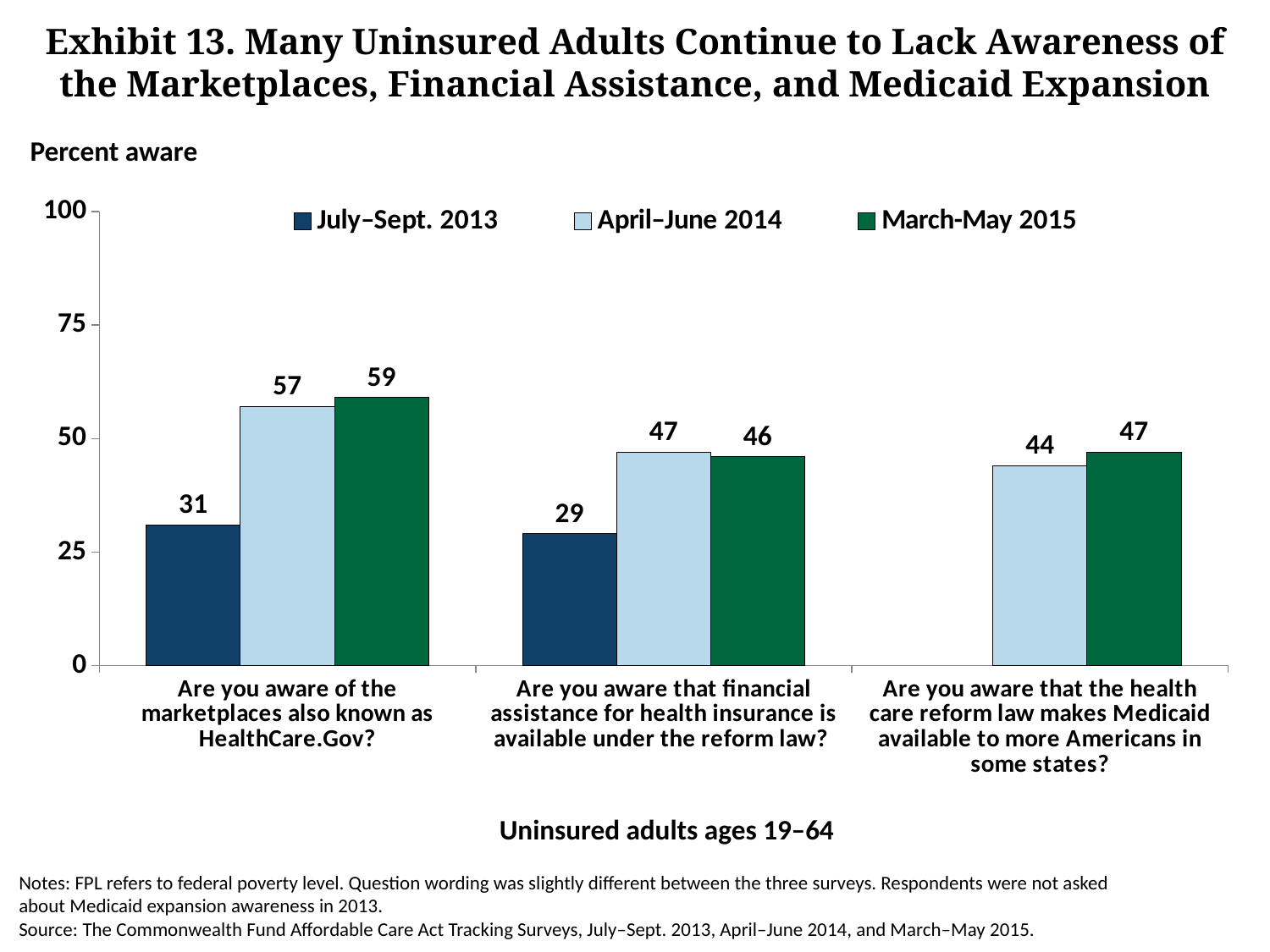
What percent of uninsured adults were aware that the reform law makes Medicaid available to more Americans in April–June 2014? 44 Which survey period has no bar for the Medicaid expansion awareness question? July–Sept. 2013 How many series does the legend list? 3 What percent of uninsured adults were aware of the marketplaces (HealthCare.Gov) in March-May 2015? 59 Which survey period had the highest awareness of the marketplaces also known as HealthCare.Gov? March-May 2015 By how many percentage points did awareness of the marketplaces increase from July–Sept. 2013 to April–June 2014? 26 Which is larger: awareness of financial assistance in April–June 2014 or in March-May 2015? April–June 2014 What percent of uninsured adults were aware that financial assistance is available under the reform law in July–Sept. 2013? 29 What type of chart is shown on the slide? bar chart Is the March-May 2015 value for awareness of the marketplaces greater or less than 50? greater How many survey questions (categories) are shown on the x axis? 3 Which survey period had the lowest awareness of financial assistance under the reform law? July–Sept. 2013